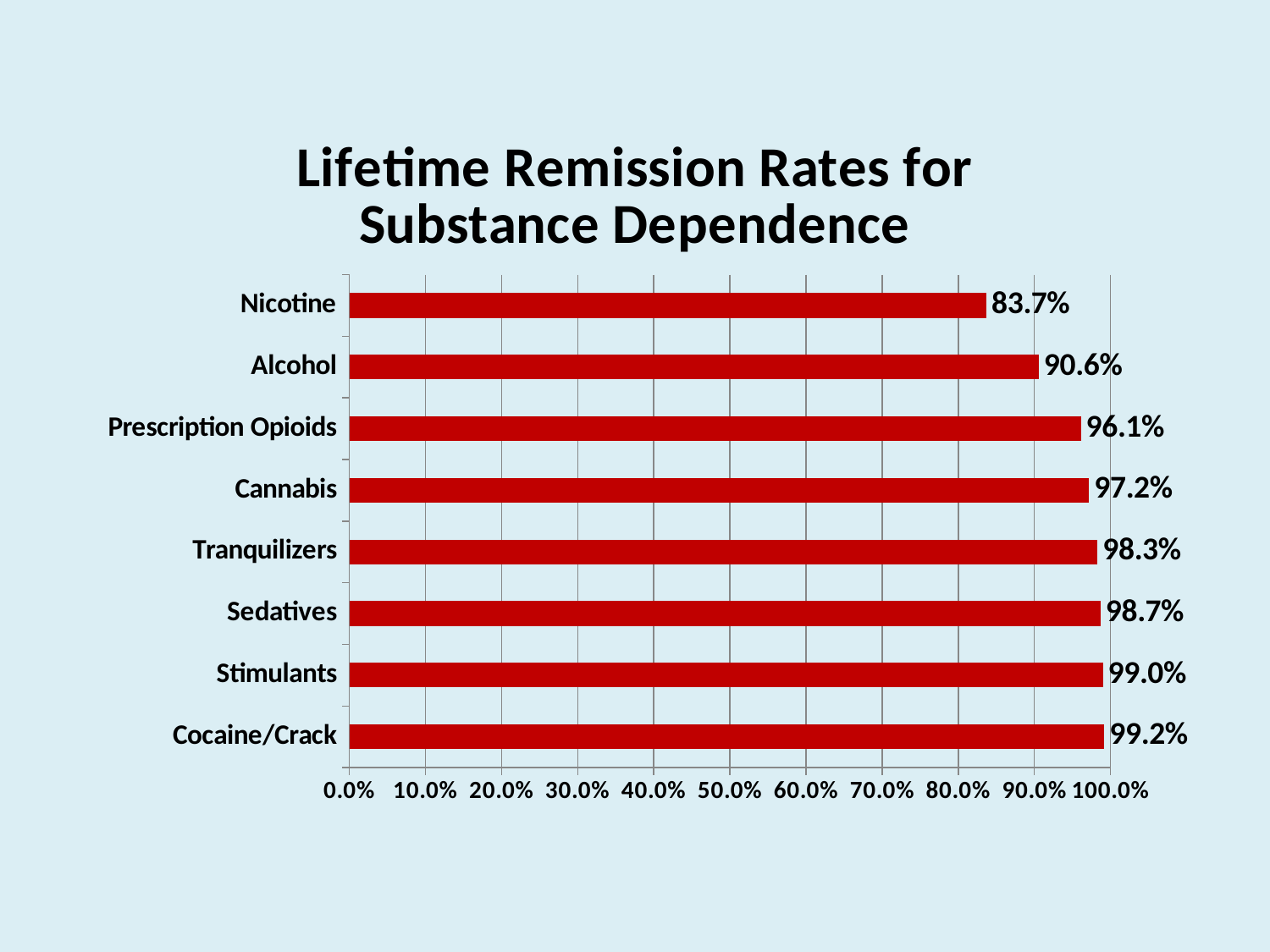
What is the lifetime remission rate for Prescription Opioids? 96.1% Which substance has the highest lifetime remission rate? Cocaine/Crack What kind of chart is shown on the slide? Bar chart What is the lifetime remission rate for Cocaine/Crack? 99.2% What is the title of the chart? Lifetime Remission Rates for Substance Dependence What is the difference between the remission rates for Alcohol and Nicotine? 6.9% Which substance has the lowest lifetime remission rate? Nicotine What is the lifetime remission rate for Alcohol? 90.6% What is the difference between the remission rates for Cocaine/Crack and Cannabis? 2.0% Which has a higher lifetime remission rate, Alcohol or Prescription Opioids? Prescription Opioids What is the lifetime remission rate for Nicotine? 83.7% How many substances are shown in the chart? 8